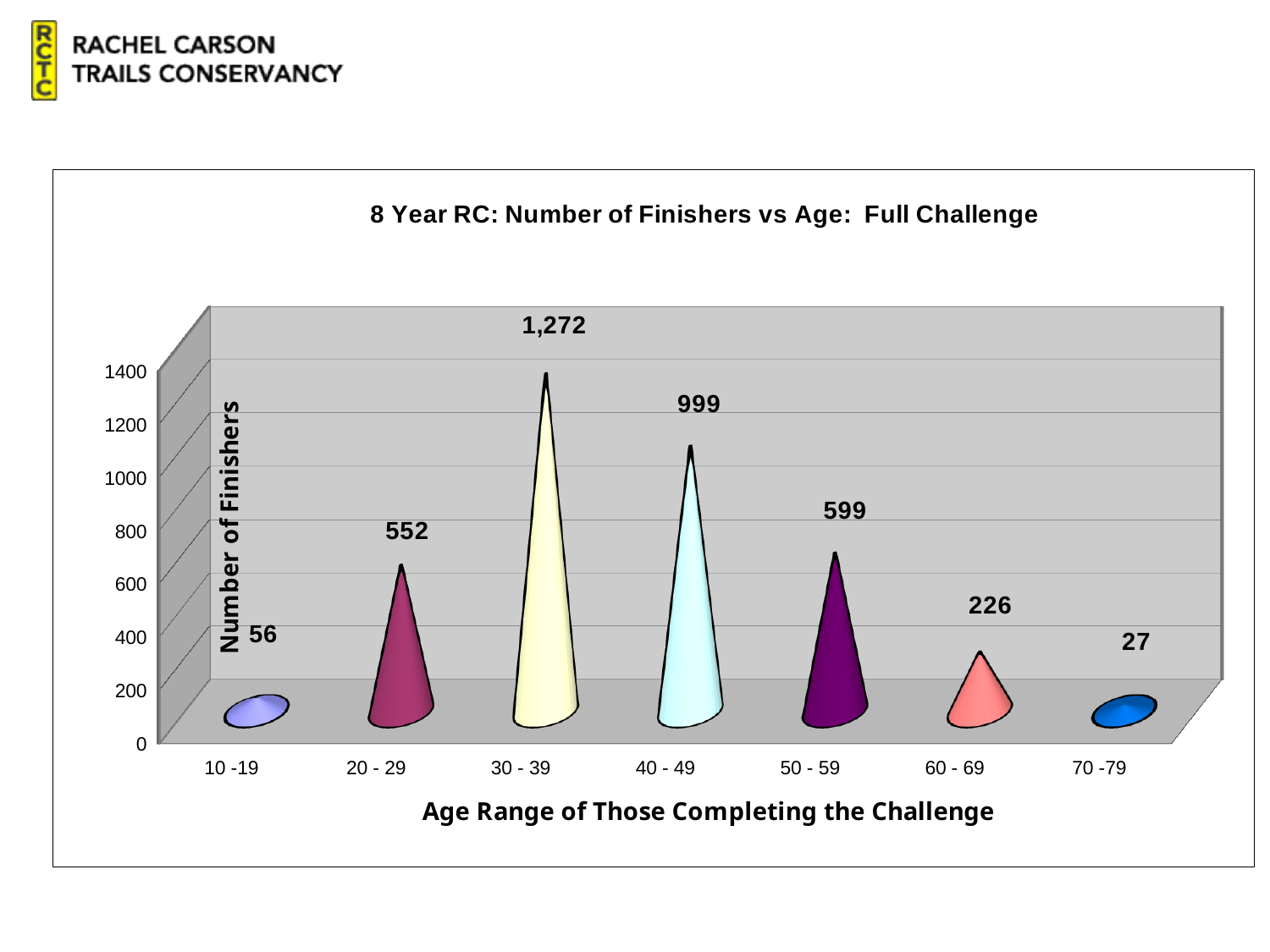
Which age range has the lowest number of finishers? 70 -79 What is the difference in number of finishers between the 20 - 29 and 50 - 59 age ranges? 47 What kind of chart is shown on the slide? Bar chart What is the title of the chart? 8 Year RC: Number of Finishers vs Age: Full Challenge What is the difference in number of finishers between the 30 - 39 and 40 - 49 age ranges? 273 What is the number of finishers for the 60 - 69 age range? 226 What is the number of finishers for the 10 -19 age range? 56 What is the number of finishers for the 30 - 39 age range? 1,272 Which age range has more finishers, 20 - 29 or 50 - 59? 50 - 59 Which age range has the highest number of finishers? 30 - 39 How many age ranges are shown on the chart? 7 What is the label of the x axis? Age Range of Those Completing the Challenge